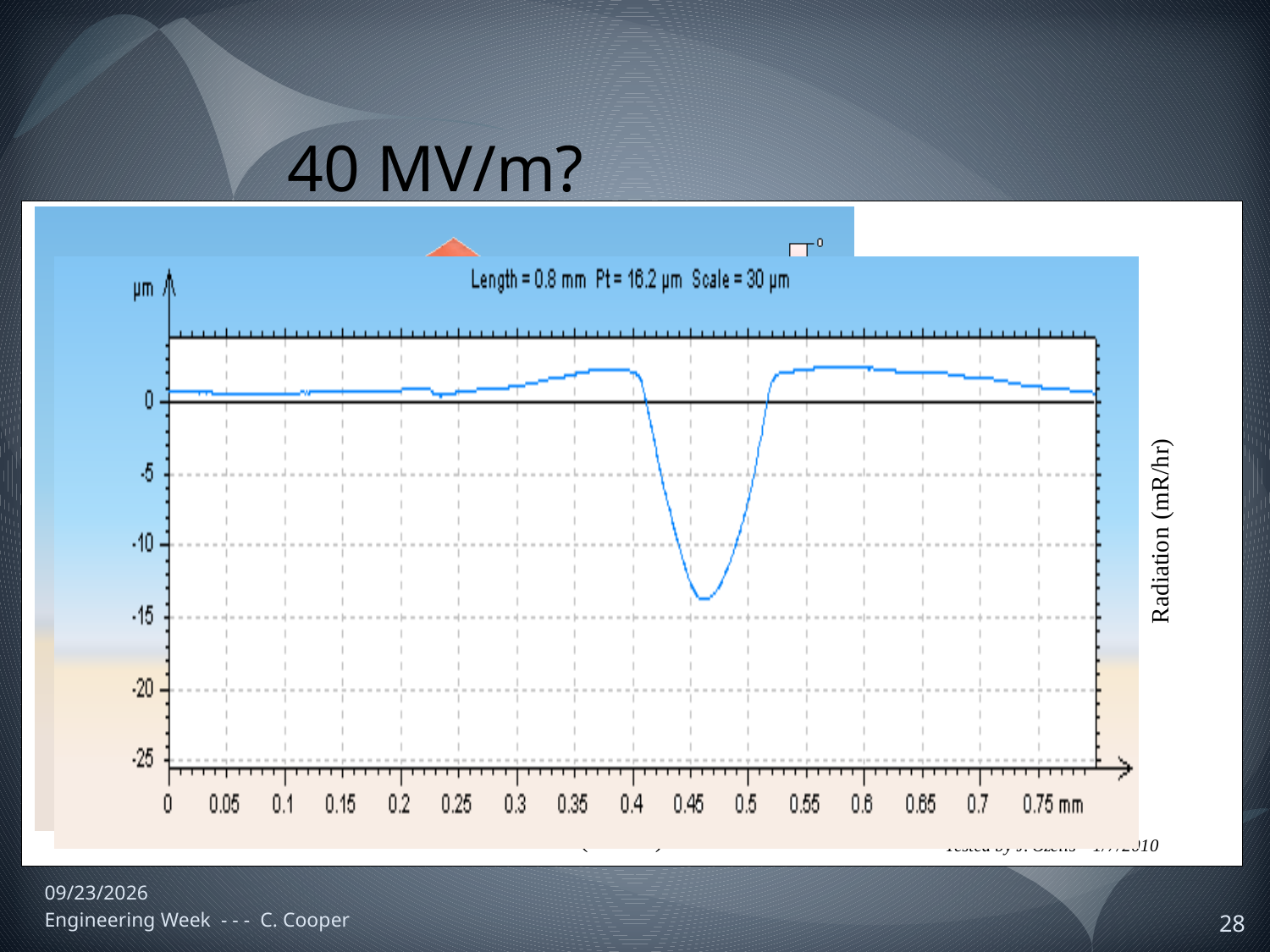
What is the Pt value printed in the header of the profile chart? 16.2 µm Between 0.4 mm and 0.47 mm, does the profile line rise or fall? fall Is the profile value at 0.2 mm greater or less than -5 µm? greater What is the Scale value printed in the header of the profile chart? 30 µm Is the lowest point of the profile line greater or less than -10 µm? less What kind of chart is shown on the slide? line chart What is the last labelled tick on the horizontal axis of the profile chart? 0.75 mm Is the profile value at 0.6 mm greater or less than 0 µm? greater What unit is shown on the vertical axis of the profile chart? µm Between 0.47 mm and 0.52 mm, does the profile line rise or fall? rise What is the Length value printed in the header of the profile chart? 0.8 mm